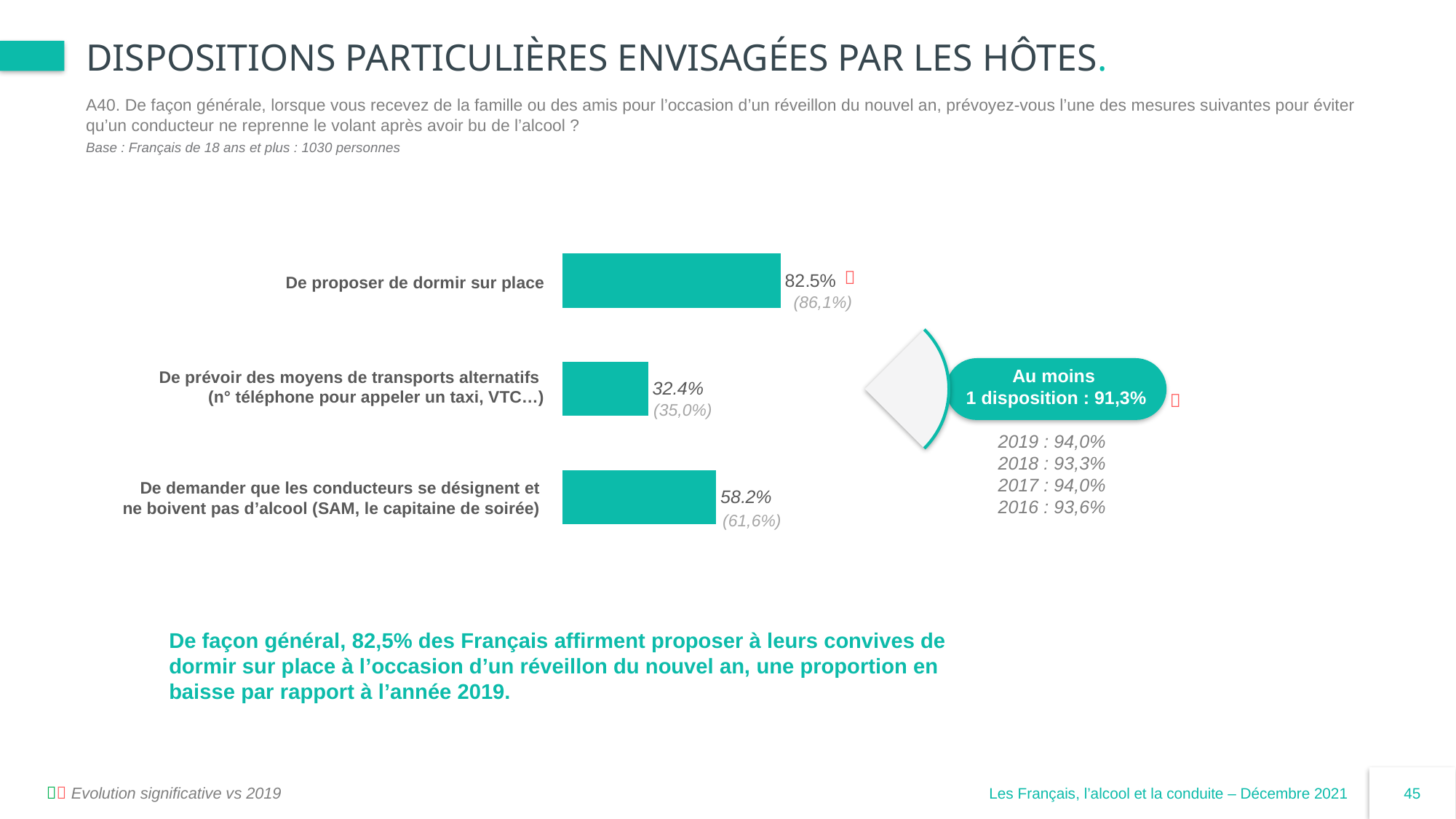
Which category has the highest value? De proposer de dormir sur place How many categories are shown in the bar chart? 3 Which category has the lowest value? De prévoir des moyens de transports alternatifs (n° téléphone pour appeler un taxi, VTC…) What is the value for "De proposer de dormir sur place"? 82.5% What was the 2019 value shown in parentheses for "De proposer de dormir sur place"? 86,1% What kind of chart is shown on the slide? Bar chart What percentage is shown for "Au moins 1 disposition"? 91,3% What is the value for "De prévoir des moyens de transports alternatifs (n° téléphone pour appeler un taxi, VTC…)"? 32.4% Which is larger: the value for "De demander que les conducteurs se désignent et ne boivent pas d'alcool" or the value for "De prévoir des moyens de transports alternatifs"? De demander que les conducteurs se désignent et ne boivent pas d'alcool What is the difference between the value for "De proposer de dormir sur place" and the value for "De demander que les conducteurs se désignent et ne boivent pas d'alcool"? 24.3% What is the value for "De demander que les conducteurs se désignent et ne boivent pas d'alcool (SAM, le capitaine de soirée)"? 58.2% What colour are the bars in the chart? Teal